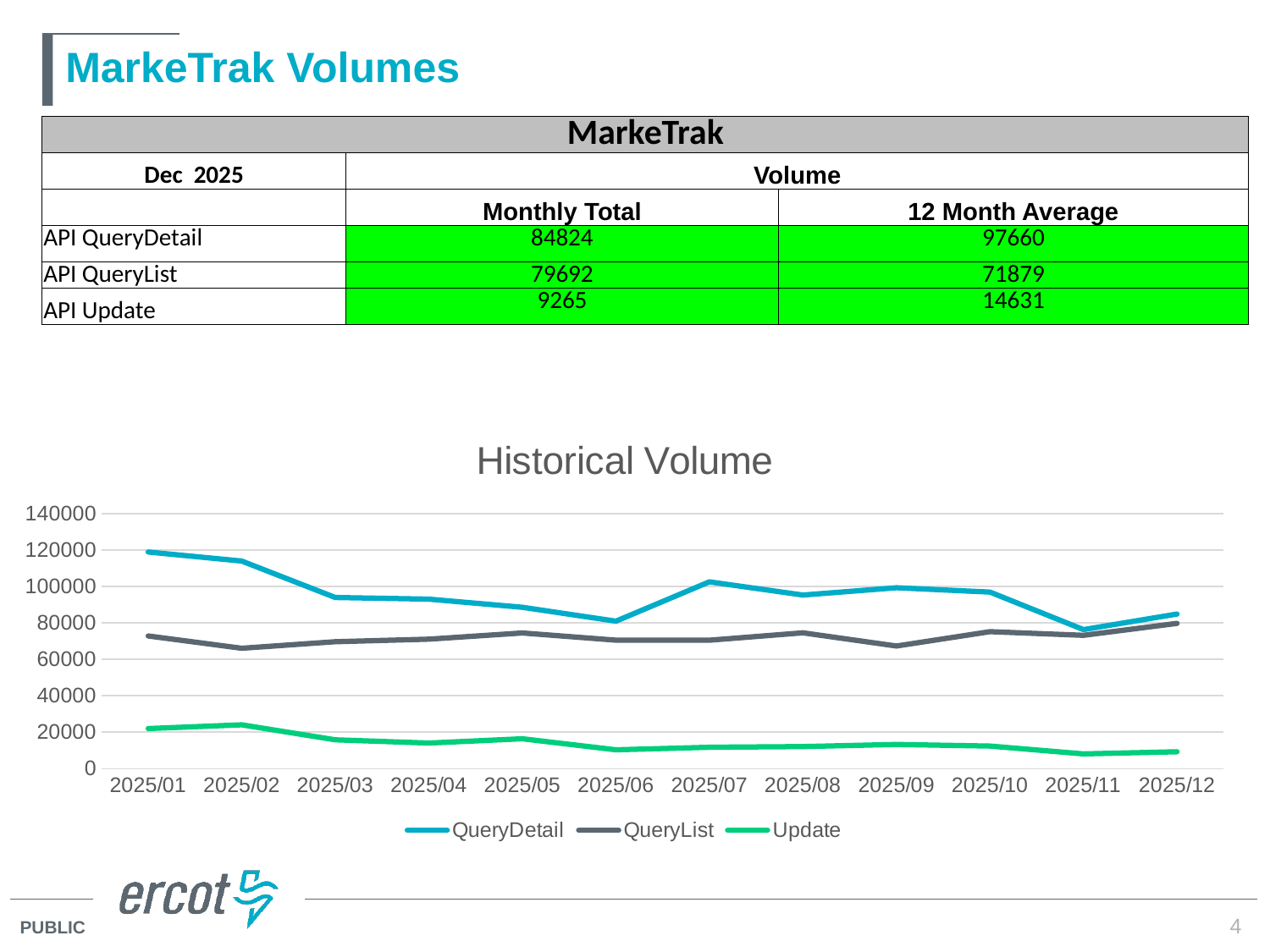
How many series does the legend of the Historical Volume chart list? 3 In the Historical Volume chart, which month has the highest QueryDetail value? 2025/01 In the Historical Volume chart, is the QueryList value for 2025/02 greater or less than 80000? less In the Historical Volume chart, is the QueryDetail value for 2025/01 greater or less than 100000? greater According to the table, what is the Monthly Total for API QueryDetail in Dec 2025? 84824 In the Historical Volume chart, does the Update series overall rise or fall from 2025/01 to 2025/12? fall How many months are plotted along the x axis of the Historical Volume chart? 12 What kind of chart is the Historical Volume chart? line chart In the Historical Volume chart, is the QueryDetail value for 2025/06 greater or less than 100000? less In the Historical Volume chart, which month has the lowest QueryDetail value? 2025/11 In the Historical Volume chart, which series is higher at 2025/01, QueryDetail or QueryList? QueryDetail